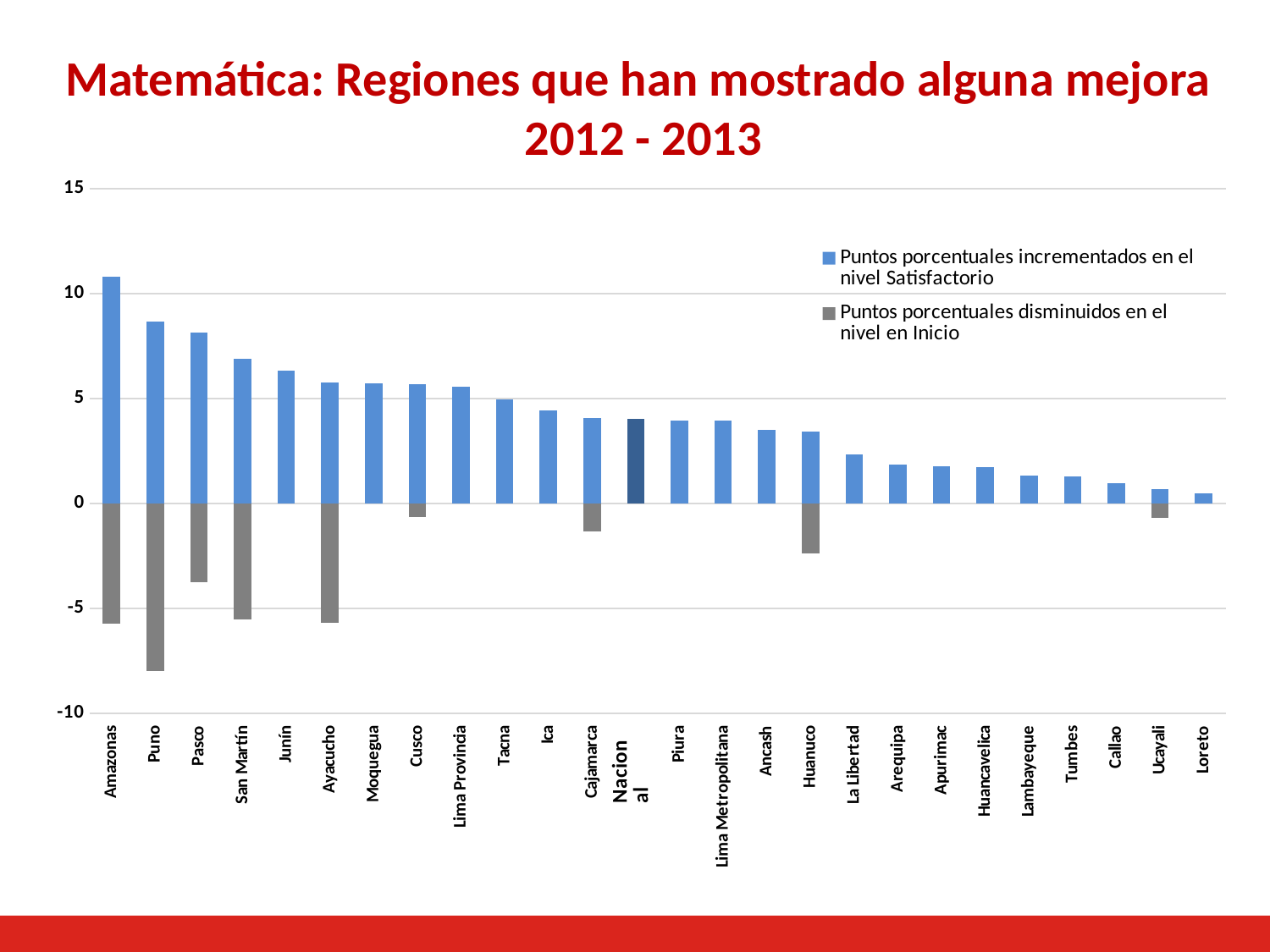
Which category has the lowest value for 'Puntos porcentuales incrementados en el nivel Satisfactorio'? Loreto How many categories are shown along the x axis? 26 Which is larger for 'Puntos porcentuales incrementados en el nivel Satisfactorio': Amazonas or Puno? Amazonas Which region has the highest value for 'Puntos porcentuales incrementados en el nivel Satisfactorio'? Amazonas What is the title of the chart? Matemática: Regiones que han mostrado alguna mejora 2012 - 2013 Is the value for Puno in 'Puntos porcentuales disminuidos en el nivel en Inicio' greater or less than -5? less Which region has the lowest (most negative) value for 'Puntos porcentuales disminuidos en el nivel en Inicio'? Puno Is the value for Junín in 'Puntos porcentuales incrementados en el nivel Satisfactorio' greater or less than 5? greater Is the value for Amazonas in 'Puntos porcentuales incrementados en el nivel Satisfactorio' greater or less than 10? greater Do the values for 'Puntos porcentuales incrementados en el nivel Satisfactorio' rise or fall from left to right along the x axis? fall How many series does the legend list? 2 What kind of chart is shown on the slide? bar chart